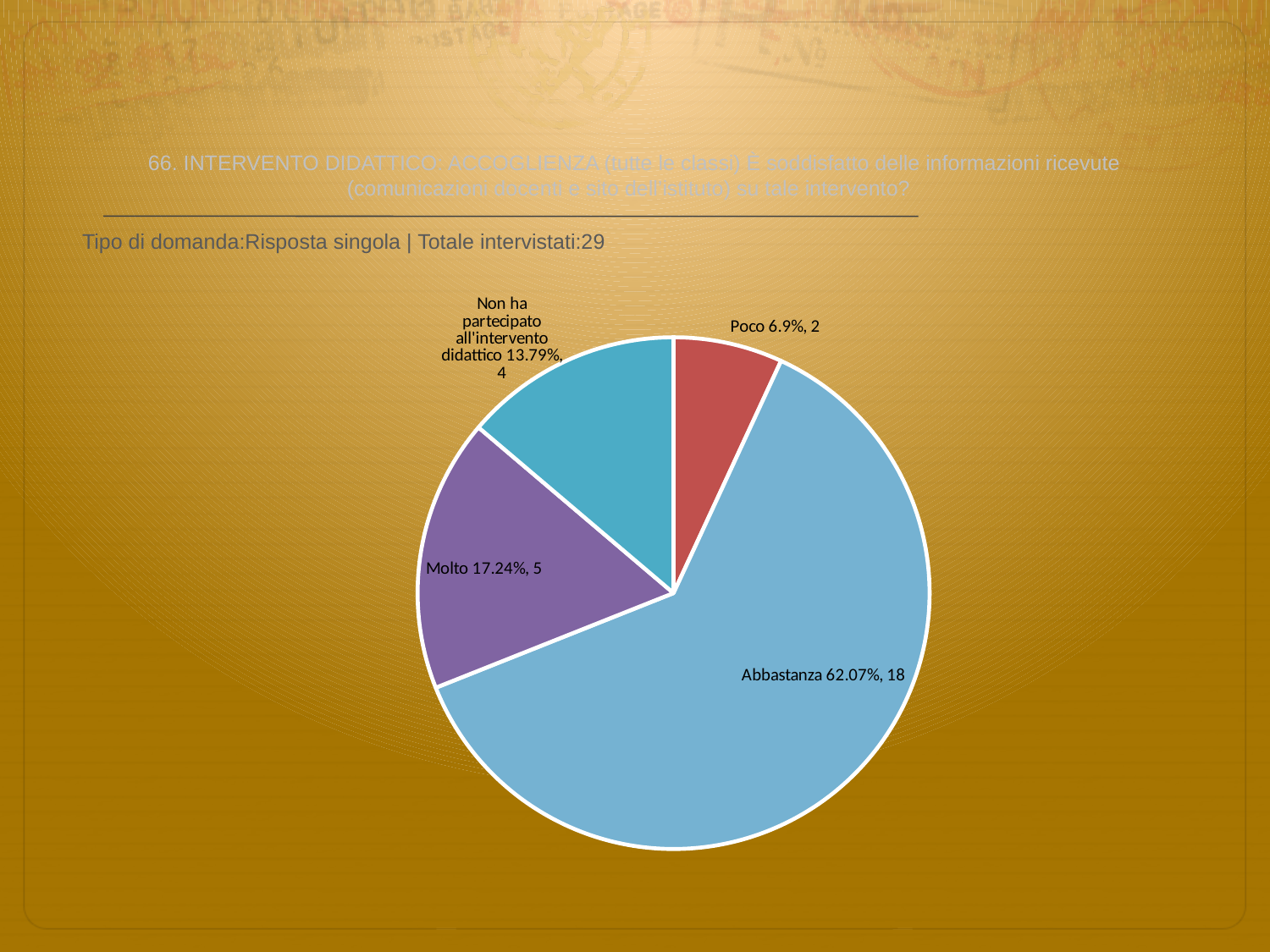
What kind of chart is shown on the slide? pie chart Which category has the smallest slice of the pie? Poco What is the total number of respondents stated on the slide? 29 Which category has the largest slice of the pie? Abbastanza How many slices does the pie chart have? 4 What percentage is shown for the Poco slice? 6.9% How many respondents are in the 'Non ha partecipato all'intervento didattico' slice? 4 What share of the pie does the Molto slice represent? 17.24% Which slice is larger, Molto or Poco? Molto What is the difference in respondent count between Abbastanza and Molto? 13 What percentage is shown for the Abbastanza slice? 62.07% How many respondents answered Molto? 5